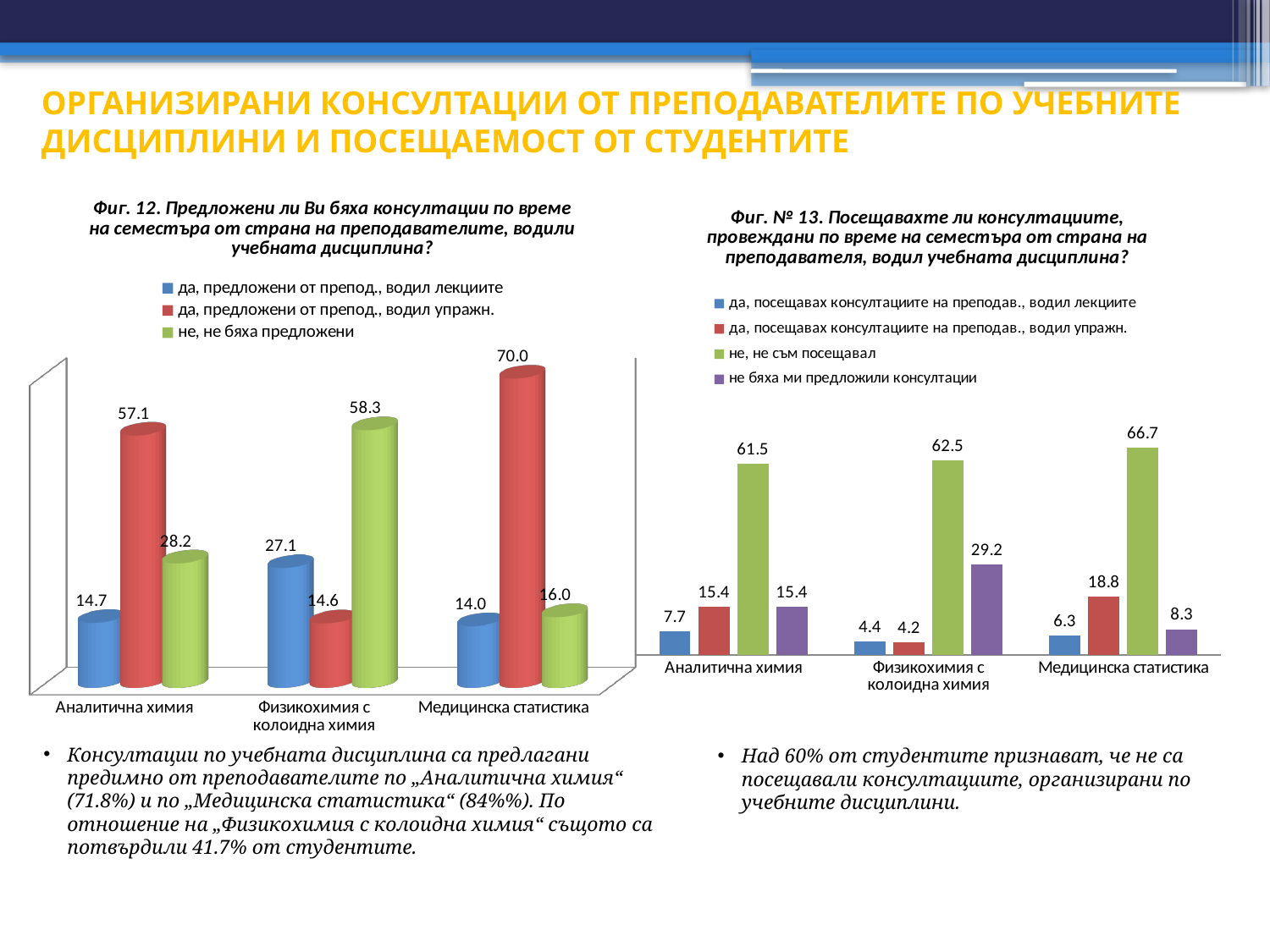
In the left chart (Фиг. 12), which category has the highest value for "да, предложени от препод., водил упражн."? Медицинска статистика In the right chart (Фиг. № 13), is the "да, посещавах консултациите на преподав., водил лекциите" value larger for Аналитична химия or for Медицинска статистика? Аналитична химия In the left chart (Фиг. 12), how many series does the legend list? 3 In the right chart (Фиг. № 13), how many categories are shown on the x axis? 3 In the right chart (Фиг. № 13), how many series does the legend list? 4 In the right chart (Фиг. № 13), which category has the lowest value for "да, посещавах консултациите на преподав., водил упражн."? Физикохимия с колоидна химия In the left chart (Фиг. 12), what kind of chart is shown? Bar chart In the left chart (Фиг. 12), what is the difference between the "да, предложени от препод., водил упражн." value and the "да, предложени от препод., водил лекциите" value for Медицинска статистика? 56.0 In the left chart (Фиг. 12), what is the value for "да, предложени от препод., водил упражн." for Аналитична химия? 57.1 In the right chart (Фиг. № 13), what is the value for "не, не съм посещавал" for Медицинска статистика? 66.7 In the right chart (Фиг. № 13), what is the value for "не бяха ми предложили консултации" for Физикохимия с колоидна химия? 29.2 In the left chart (Фиг. 12), what is the value for "не, не бяха предложени" for Физикохимия с колоидна химия? 58.3